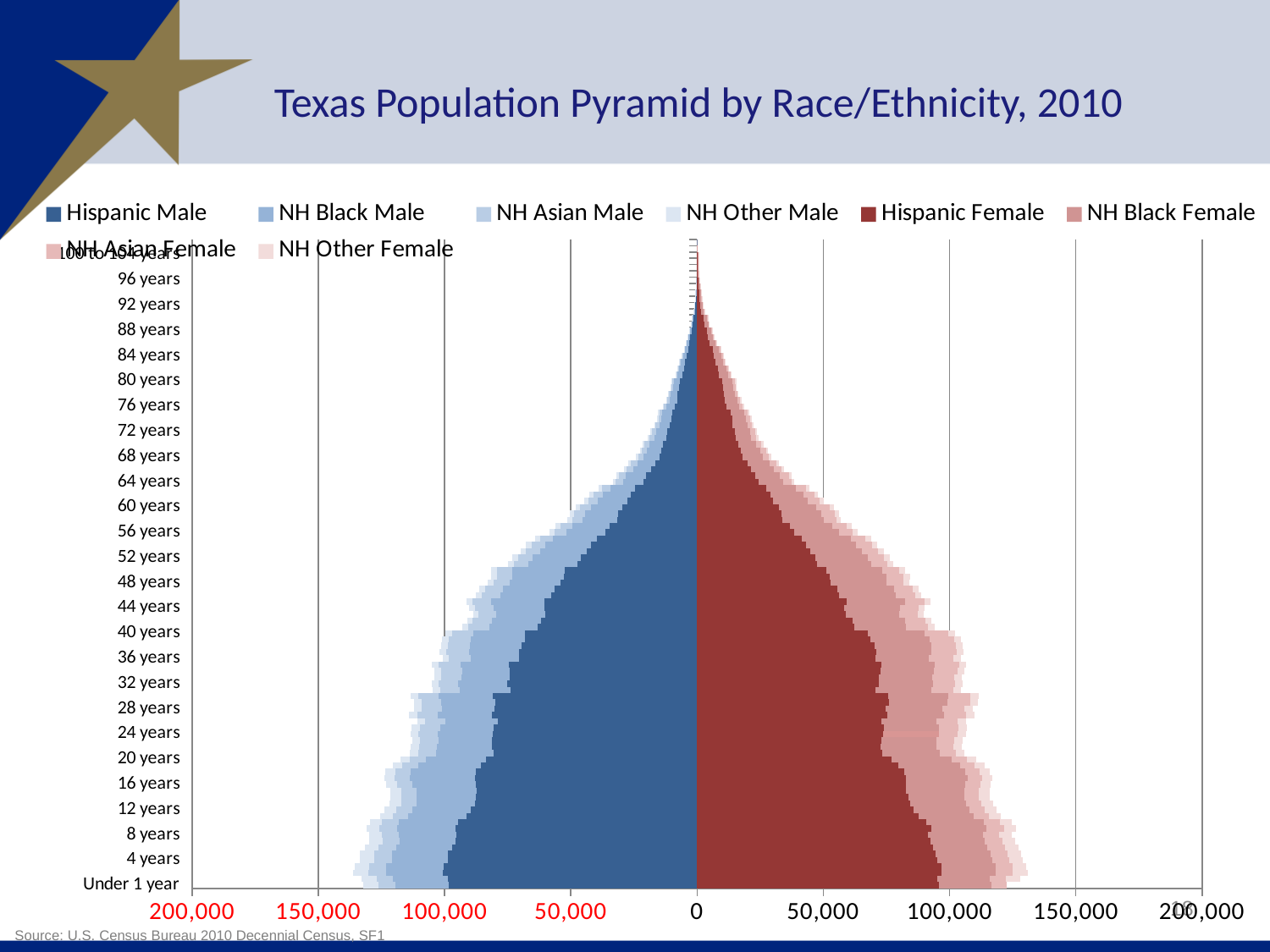
Is the Hispanic Female value for 80 years greater or less than 50,000? less Which series is listed first in the legend? Hispanic Male What is the title of the chart? Texas Population Pyramid by Race/Ethnicity, 2010 Which is larger, the Hispanic Male value for Under 1 year or for 80 years? Under 1 year What is the largest value shown on the horizontal axis? 200,000 Which is larger, the Hispanic Female value for 4 years or for 72 years? 4 years How many series does the legend list? 8 Is the Hispanic Male value for 64 years greater or less than 50,000? less Is the Hispanic Female value for 20 years greater or less than 50,000? greater What kind of chart is shown on the slide? Bar chart (population pyramid) Do the Hispanic Male values generally rise or fall as age increases from Under 1 year to 100 to 104 years? fall